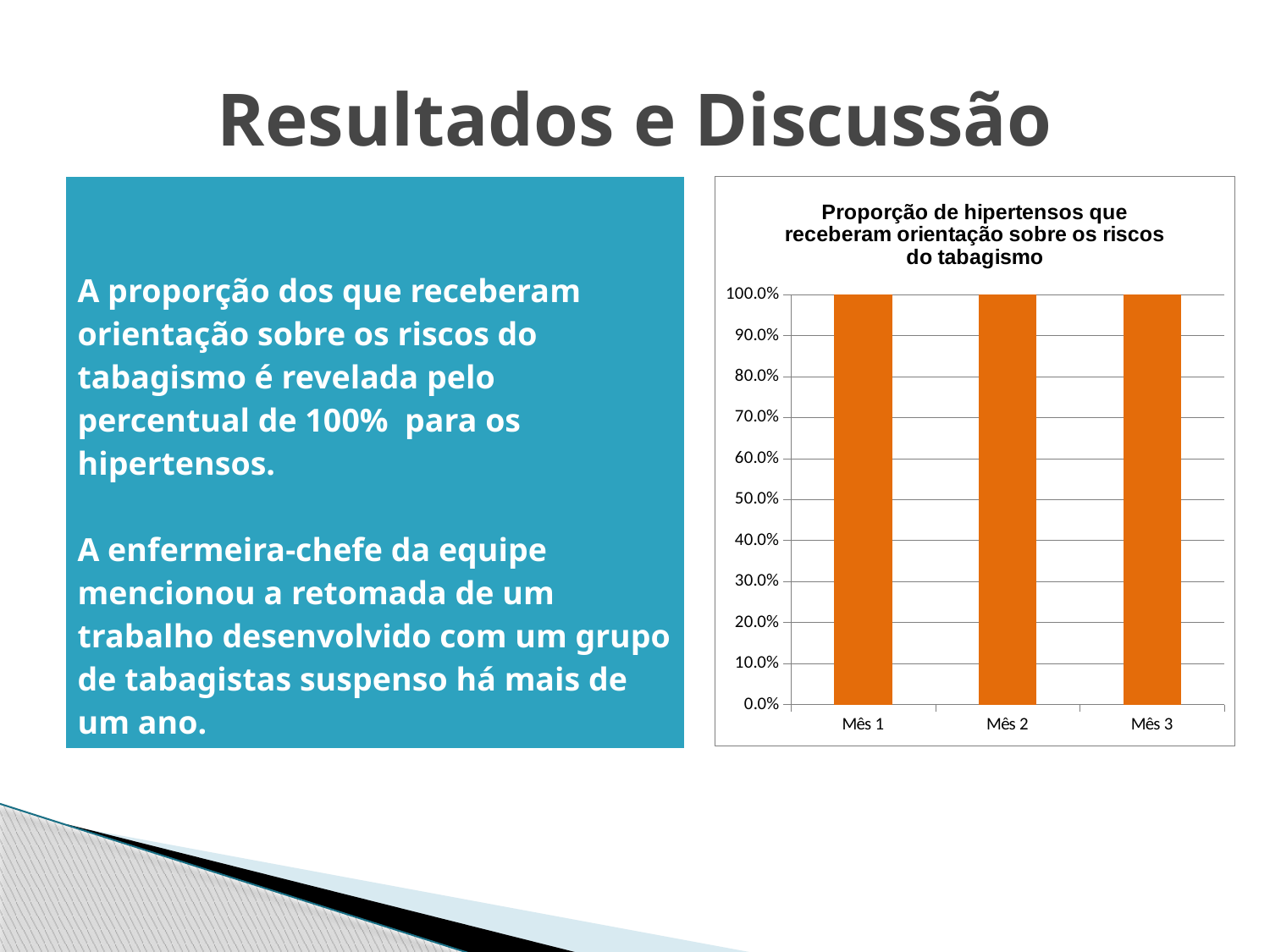
Is the value for Mês 3 greater or less than 90.0%? greater What is the title of the chart? Proporção de hipertensos que receberam orientação sobre os riscos do tabagismo What colour are the bars in the chart? Orange Do the values rise, fall or stay the same from Mês 1 to Mês 3? Stay the same What is the highest value shown on the y axis of the chart? 100.0% What kind of chart is shown on the slide? Bar chart How many categories are shown on the x axis of the chart? 3 What is the value for Mês 3 in the chart? 100.0% What is the value for Mês 1 in the chart? 100.0% What is the difference between the values for Mês 1 and Mês 3? 0.0% What is the value for Mês 2 in the chart? 100.0% Is the value for Mês 2 greater or less than 50.0%? greater